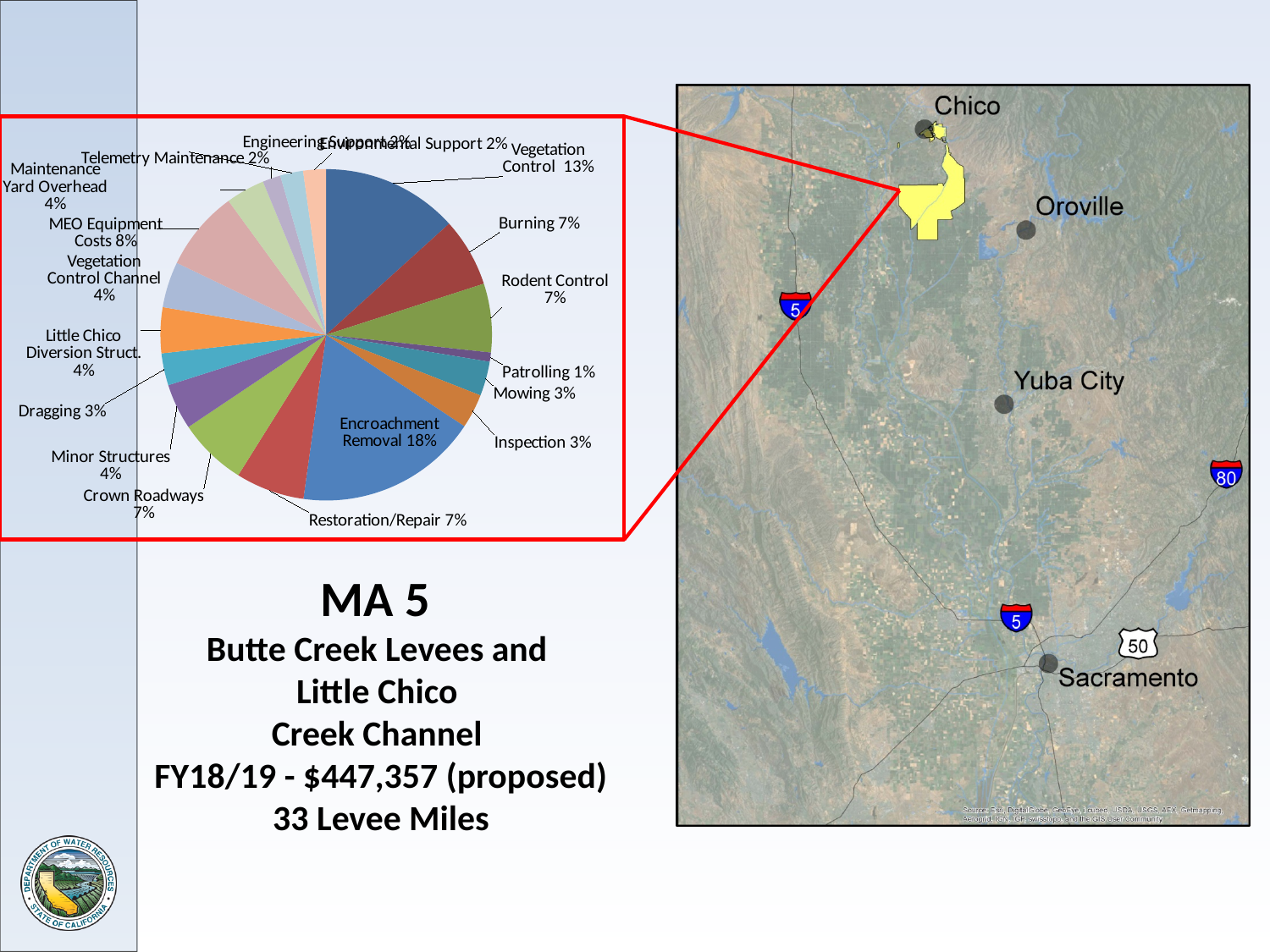
What percentage is shown for Patrolling? 1% What is the combined percentage of Dragging and Inspection? 6% What percentage of the pie chart is Encroachment Removal? 18% What percentage is shown for Restoration/Repair? 7% Which category has the smallest share of the pie chart? Patrolling Which category has the largest share of the pie chart? Encroachment Removal What is the difference in percentage points between Encroachment Removal and Vegetation Control? 5 What percentage is shown for Telemetry Maintenance? 2% What percentage is shown for MEO Equipment Costs? 8% What share of the pie does Vegetation Control represent? 13% Which is larger, the share for Burning or the share for Mowing? Burning What type of chart is shown on the slide? pie chart